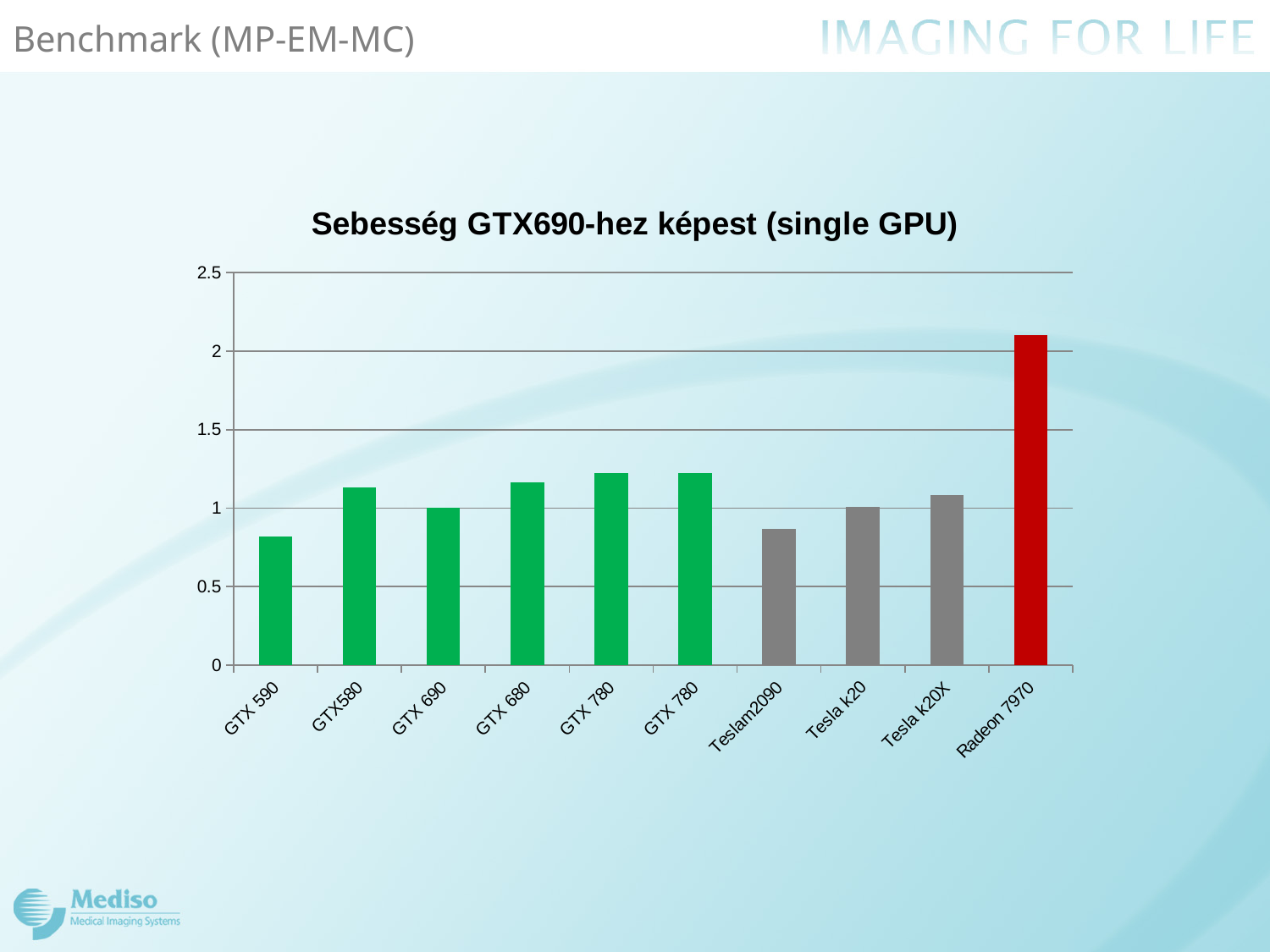
Is the value for Radeon 7970 greater or less than 2? greater Is the value for GTX 590 greater or less than 1? less What colour is the bar for Radeon 7970? red Which category has the highest value in the chart? Radeon 7970 What is the value for GTX 690? 1 Which is larger, the value for GTX 590 or the value for GTX580? GTX580 Is the value for GTX 680 greater or less than 1? greater What is the title of the chart? Sebesség GTX690-hez képest (single GPU) What kind of chart is shown on the slide? bar chart How many bars (categories) are plotted in the chart? 10 Which category has the lowest value in the chart? GTX 590